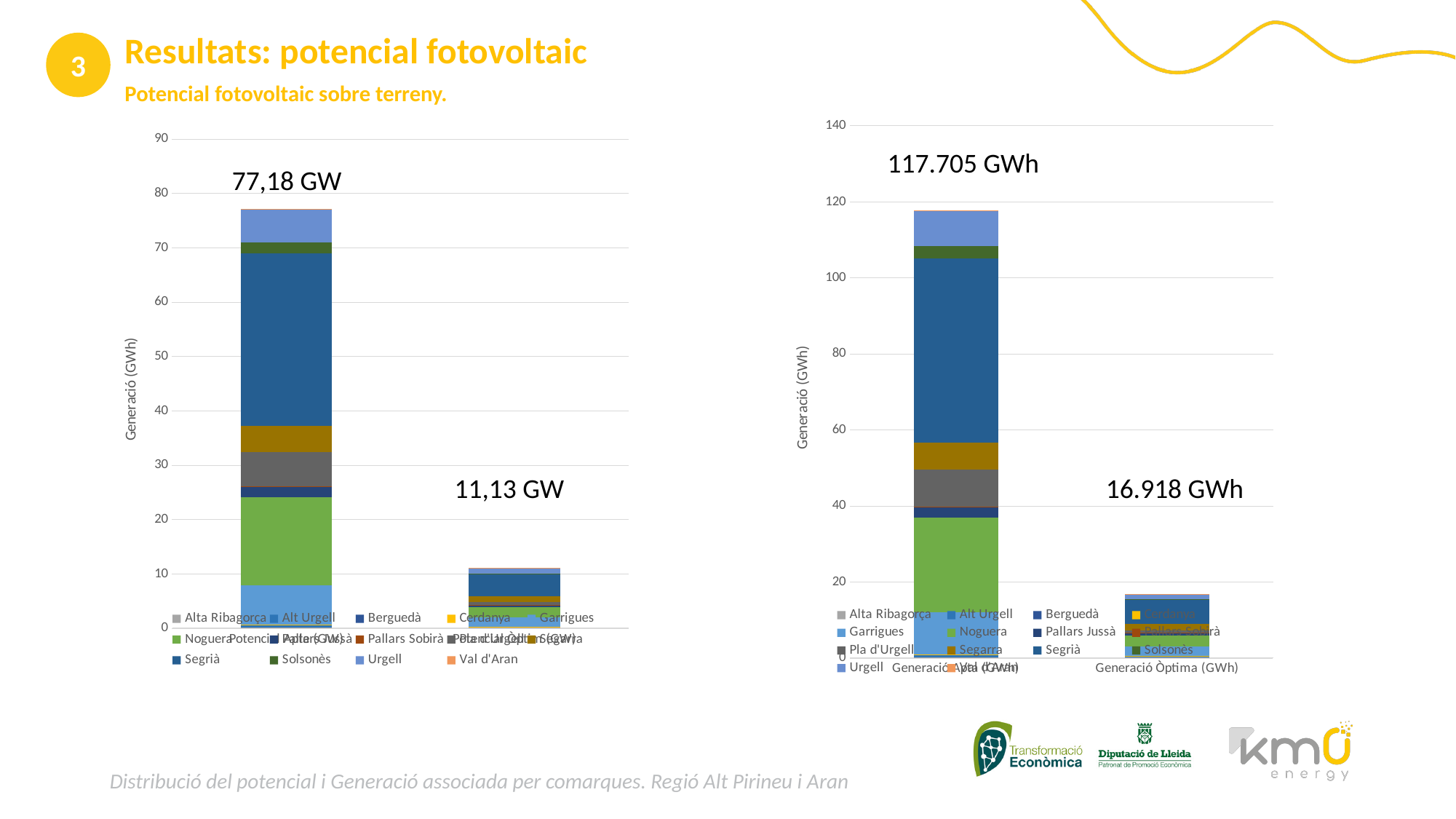
In the chart on the right, which bar has the larger total, the left bar or the right bar? the left bar In the chart on the left, what is the difference between the two labelled bar totals? 66,05 GW In the chart on the right, is the total of the right bar greater or less than 20? less In the chart on the right, what total value is labelled on the taller bar? 117.705 GWh How many series does the legend of the chart on the left list? 14 In the chart on the right, what total value is labelled on the shorter bar? 16.918 GWh How many bars are plotted in the chart on the right? 2 In the chart on the right, what is the difference between the two labelled bar totals? 100.787 GWh What kind of chart is the chart on the left of the slide? stacked bar chart In the chart on the left, is the total of the left bar greater or less than 70? greater In the chart on the left, what total value is labelled on the shorter bar? 11,13 GW